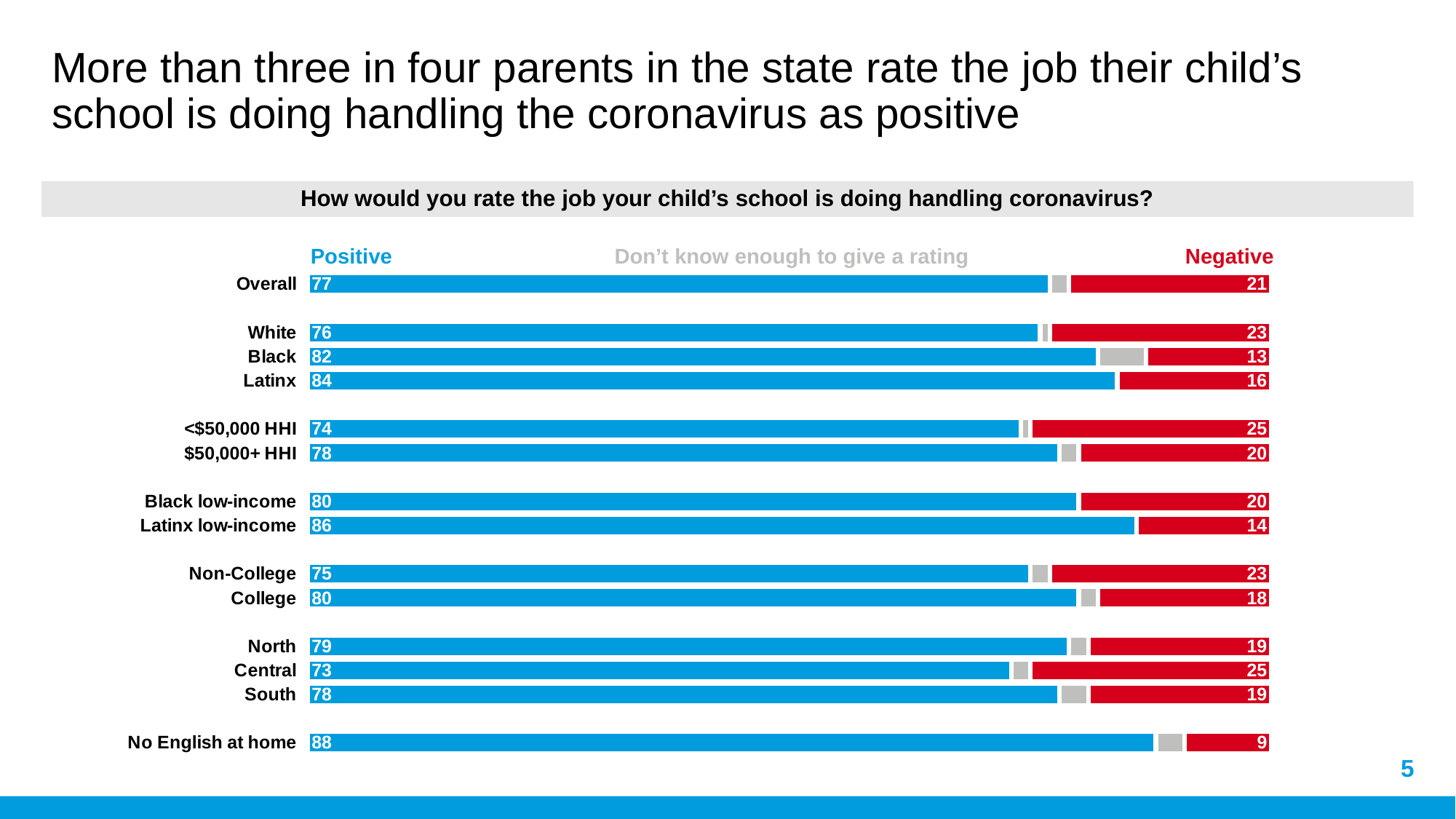
What is the Positive value for No English at home? 88 How many categories are shown in the chart? 14 Which category has the lowest Positive value? Central How many series does the chart show? 3 What is the Positive value for Overall? 77 Which category has the highest Positive value? No English at home Which category has the lowest Negative value? No English at home Which has a higher Positive value, College or Non-College? College What type of chart is shown on the slide? Stacked bar chart What is the difference between the Positive values for Latinx and White? 8 What is the difference between the Negative values for <$50,000 HHI and $50,000+ HHI? 5 What is the Negative value for Black low-income parents? 20